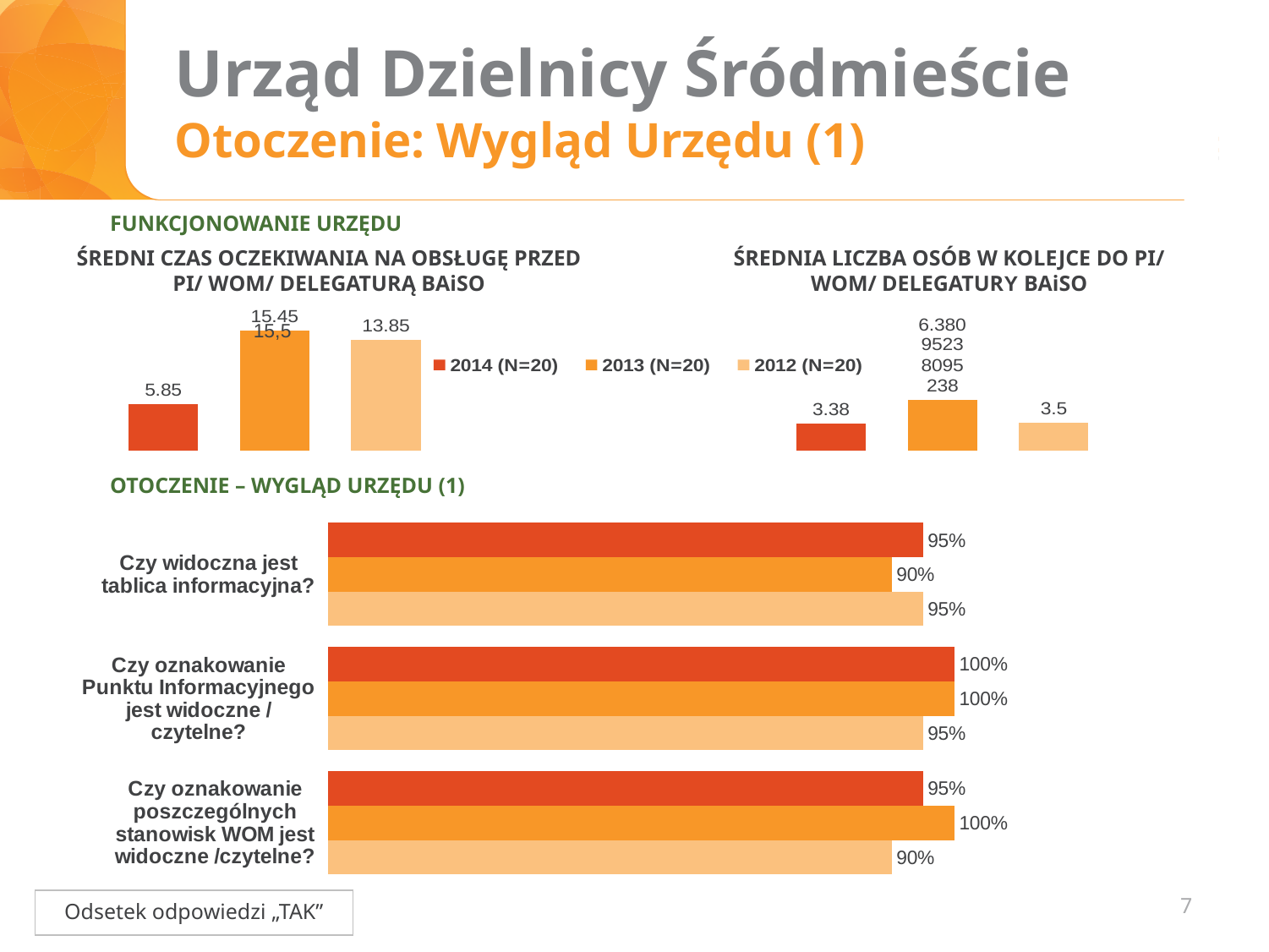
In the chart 'ŚREDNI CZAS OCZEKIWANIA NA OBSŁUGĘ PRZED PI/ WOM/ DELEGATURĄ BAiSO', which year has the lowest value? 2014 (N=20) How many series does the legend of the top charts list? 3 In the chart 'ŚREDNI CZAS OCZEKIWANIA NA OBSŁUGĘ PRZED PI/ WOM/ DELEGATURĄ BAiSO', what is the value for 2014 (N=20)? 5.85 In the bottom chart 'OTOCZENIE – WYGLĄD URZĘDU (1)', what is the 2013 value for 'Czy widoczna jest tablica informacyjna?'? 90% In the chart 'ŚREDNIA LICZBA OSÓB W KOLEJCE DO PI/ WOM/ DELEGATURY BAiSO', what is the value for 2014 (N=20)? 3.38 In the bottom chart 'OTOCZENIE – WYGLĄD URZĘDU (1)', what is the 2014 value for 'Czy oznakowanie poszczególnych stanowisk WOM jest widoczne /czytelne?'? 95% In the chart 'ŚREDNIA LICZBA OSÓB W KOLEJCE DO PI/ WOM/ DELEGATURY BAiSO', what is the value for 2012 (N=20)? 3.5 In the bottom chart 'OTOCZENIE – WYGLĄD URZĘDU (1)', what is the 2012 value for 'Czy oznakowanie Punktu Informacyjnego jest widoczne / czytelne?'? 95% In the chart 'ŚREDNI CZAS OCZEKIWANIA NA OBSŁUGĘ PRZED PI/ WOM/ DELEGATURĄ BAiSO', what is the difference between the 2012 and 2014 values? 8 In the bottom chart 'OTOCZENIE – WYGLĄD URZĘDU (1)', how many question categories are shown? 3 What type of chart is the bottom chart 'OTOCZENIE – WYGLĄD URZĘDU (1)'? Bar chart In the chart 'ŚREDNI CZAS OCZEKIWANIA NA OBSŁUGĘ PRZED PI/ WOM/ DELEGATURĄ BAiSO', what is the value for 2012 (N=20)? 13.85